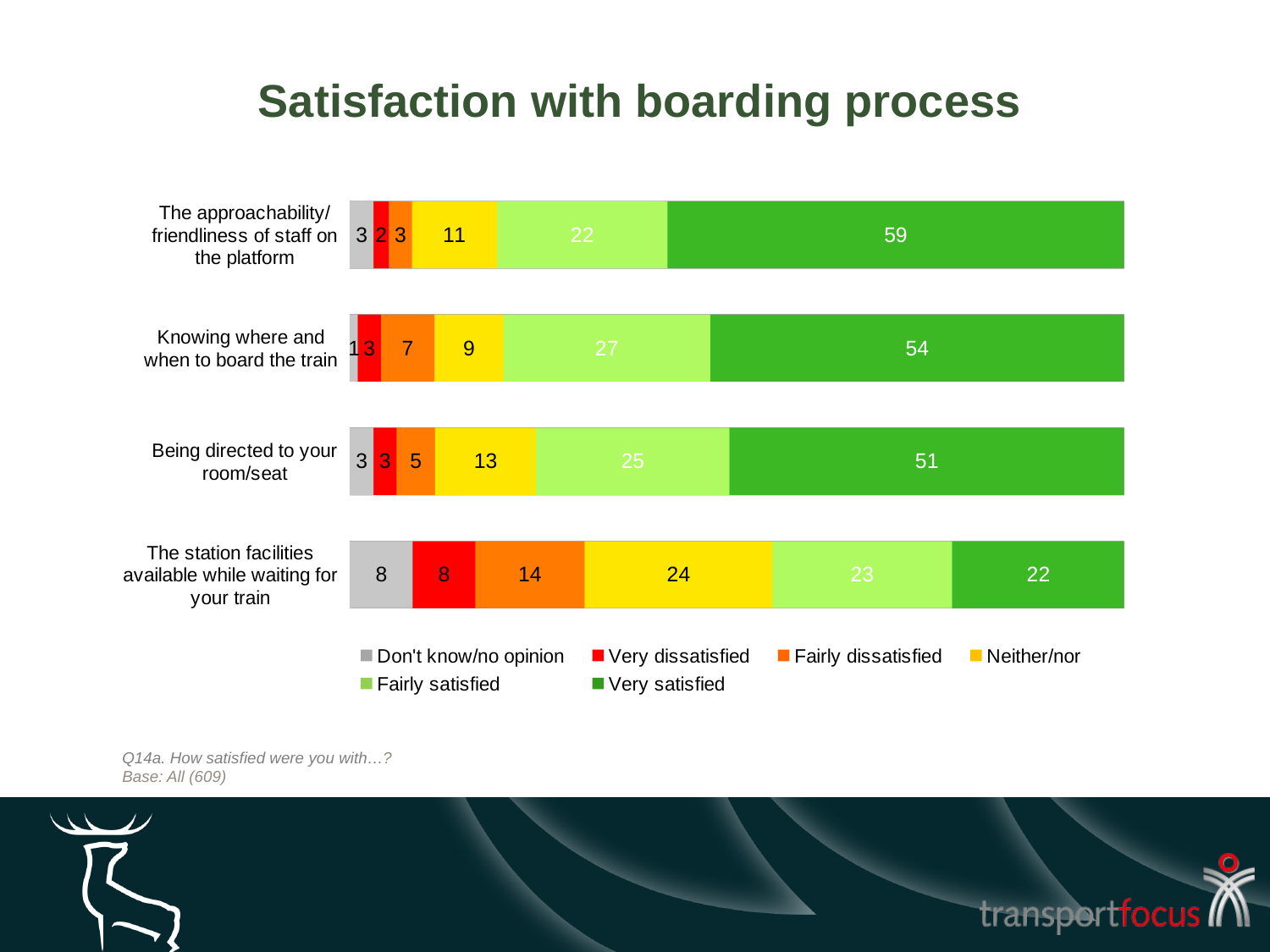
Which category has the lowest 'Very satisfied' value? The station facilities available while waiting for your train What is the 'Neither/nor' value for 'The station facilities available while waiting for your train'? 24 Which category has the highest 'Very satisfied' value? The approachability/friendliness of staff on the platform What is the title of the chart? Satisfaction with boarding process What is the 'Fairly satisfied' value for 'Knowing where and when to board the train'? 27 What type of chart is shown on the slide? Stacked bar chart What is the 'Fairly dissatisfied' value for 'Being directed to your room/seat'? 5 How many categories (aspects of the boarding process) are shown in the chart? 4 What is the 'Very satisfied' value for 'The approachability/friendliness of staff on the platform'? 59 What is the difference between the 'Very satisfied' values for 'The approachability/friendliness of staff on the platform' and 'Being directed to your room/seat'? 8 Which is larger: the 'Very dissatisfied' value for 'The station facilities available while waiting for your train' or for 'Being directed to your room/seat'? The station facilities available while waiting for your train How many series does the legend list? 6